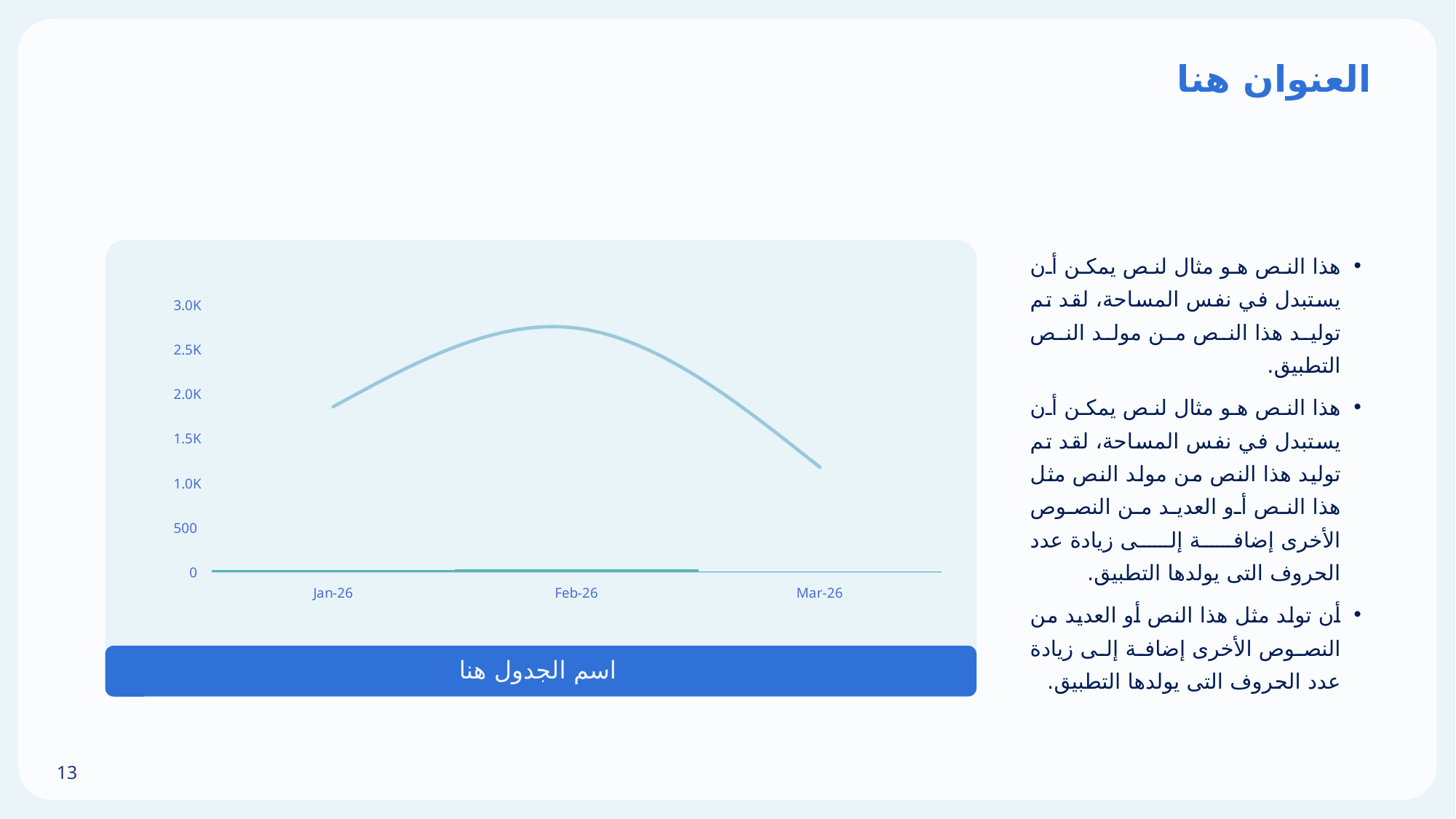
Is the value for Mar-26 greater or less than 1.5K? less How does the curved line change from Jan-26 to Mar-26? rises to Feb-26, then falls Is the value for Feb-26 greater or less than 2.5K? greater What is the highest tick label shown on the y axis of the chart? 3.0K Which month has the lowest value on the curved line? Mar-26 What kind of chart is shown on the slide? line chart Is the value for Feb-26 greater or less than 3.0K? less How many months are labelled on the x axis of the chart? 3 Which month has the highest value on the curved line? Feb-26 Which is larger, the value for Jan-26 or the value for Mar-26? Jan-26 Which is larger, the value for Feb-26 or the value for Jan-26? Feb-26